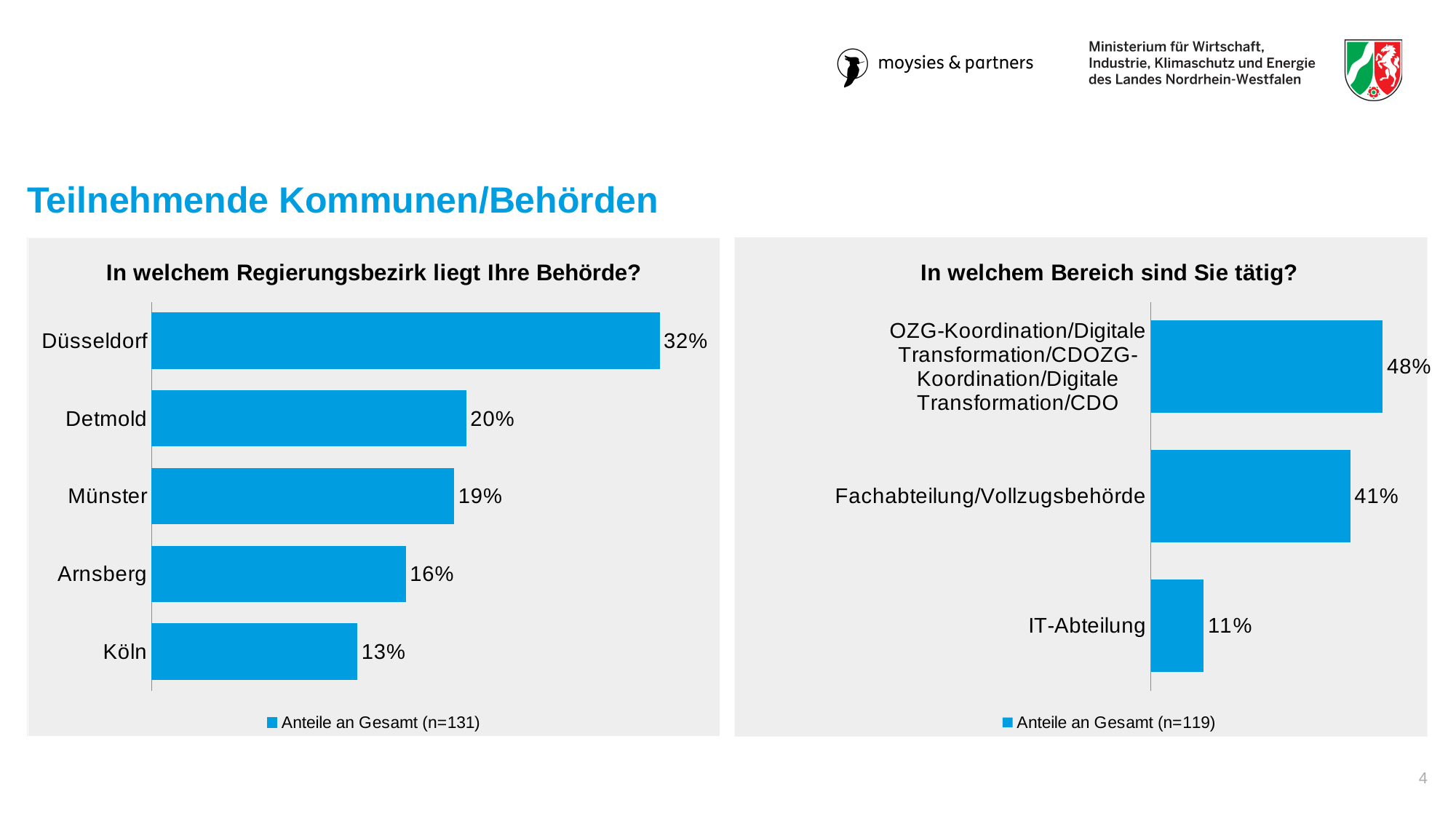
In the chart 'In welchem Regierungsbezirk liegt Ihre Behörde?', how many Regierungsbezirke are shown? 5 In the chart 'In welchem Regierungsbezirk liegt Ihre Behörde?', which Regierungsbezirk has the lowest share? Köln In the chart 'In welchem Bereich sind Sie tätig?', what is the value for Fachabteilung/Vollzugsbehörde? 41% In the chart 'In welchem Bereich sind Sie tätig?', how many series does the legend list? 1 In the chart 'In welchem Bereich sind Sie tätig?', what kind of chart is shown? Bar chart In the chart 'In welchem Bereich sind Sie tätig?', what is the value for IT-Abteilung? 11% In the chart 'In welchem Bereich sind Sie tätig?', what is the difference between Fachabteilung/Vollzugsbehörde and IT-Abteilung? 30% In the chart 'In welchem Regierungsbezirk liegt Ihre Behörde?', what is the value for Düsseldorf? 32% In the chart 'In welchem Bereich sind Sie tätig?', which category has the highest share? OZG-Koordination/Digitale Transformation/CDOZG-Koordination/Digitale Transformation/CDO In the chart 'In welchem Regierungsbezirk liegt Ihre Behörde?', what is the legend entry? Anteile an Gesamt (n=131) In the chart 'In welchem Regierungsbezirk liegt Ihre Behörde?', what is the difference between Düsseldorf and Detmold? 12% In the chart 'In welchem Regierungsbezirk liegt Ihre Behörde?', what is the value for Arnsberg? 16%